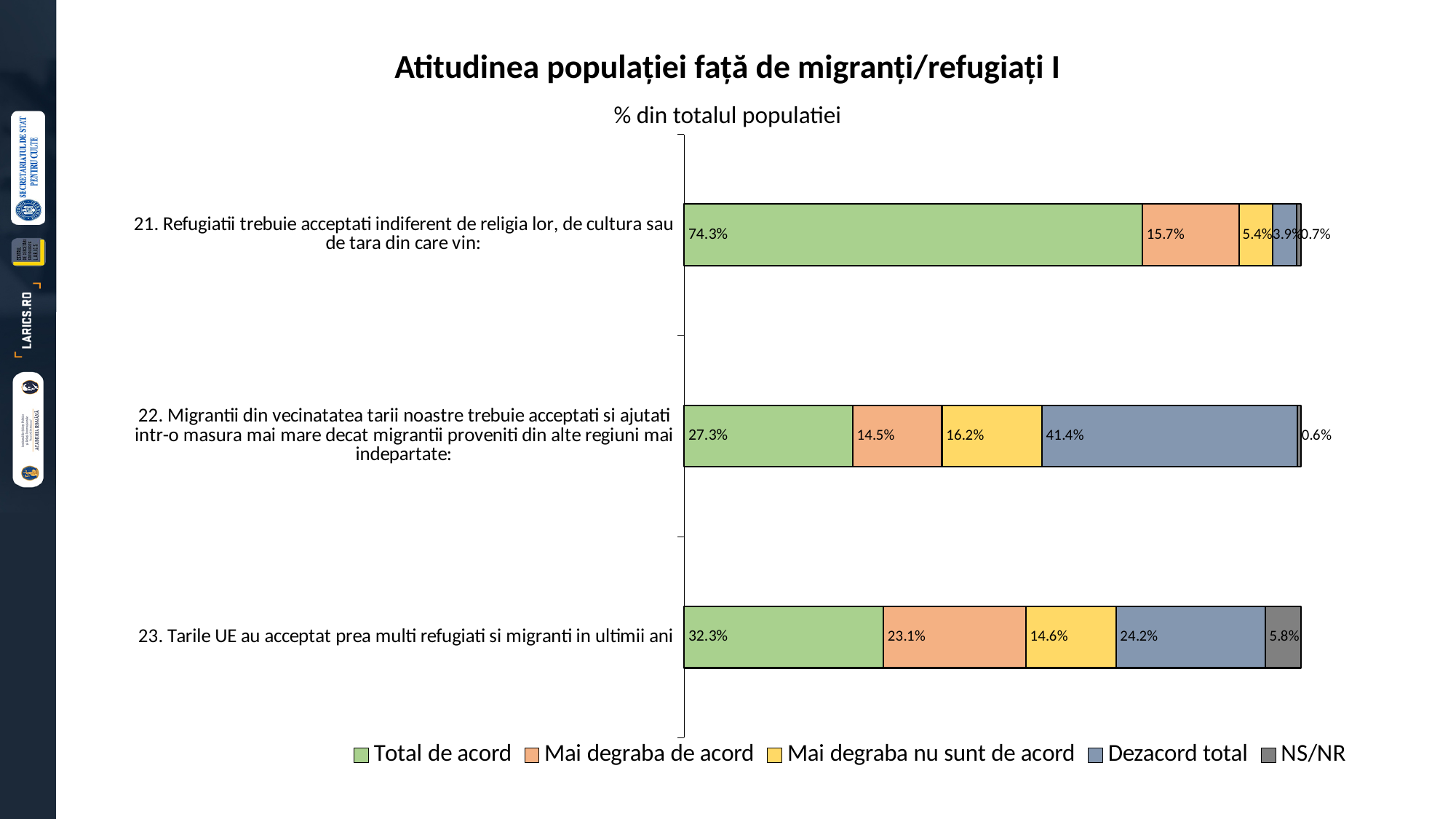
What is the difference between the "Total de acord" values for statement 21 and statement 23? 42.0 percentage points How many series does the legend list? 5 What is the "Mai degraba de acord" value for statement 23? 23.1% What is the NS/NR value for statement 23 (Tarile UE au acceptat prea multi refugiati si migranti in ultimii ani)? 5.8% What is the "Dezacord total" value for statement 22 (Migrantii din vecinatatea tarii noastre...)? 41.4% Which statement has the highest "Total de acord" share? 21. Refugiatii trebuie acceptati indiferent de religia lor, de cultura sau de tara din care vin What kind of chart is shown on the slide? Stacked bar chart How many statements (categories) are shown in the chart? 3 What is the total of the stacked bar for statement 23? 100.0% Which statement has the lowest NS/NR share? 22. Migrantii din vecinatatea tarii noastre trebuie acceptati si ajutati intr-o masura mai mare decat migrantii proveniti din alte regiuni mai indepartate What percentage of the population is "Total de acord" with statement 21 (Refugiatii trebuie acceptati indiferent de religia lor...)? 74.3% For statement 22, which is larger: "Total de acord" or "Dezacord total"? Dezacord total